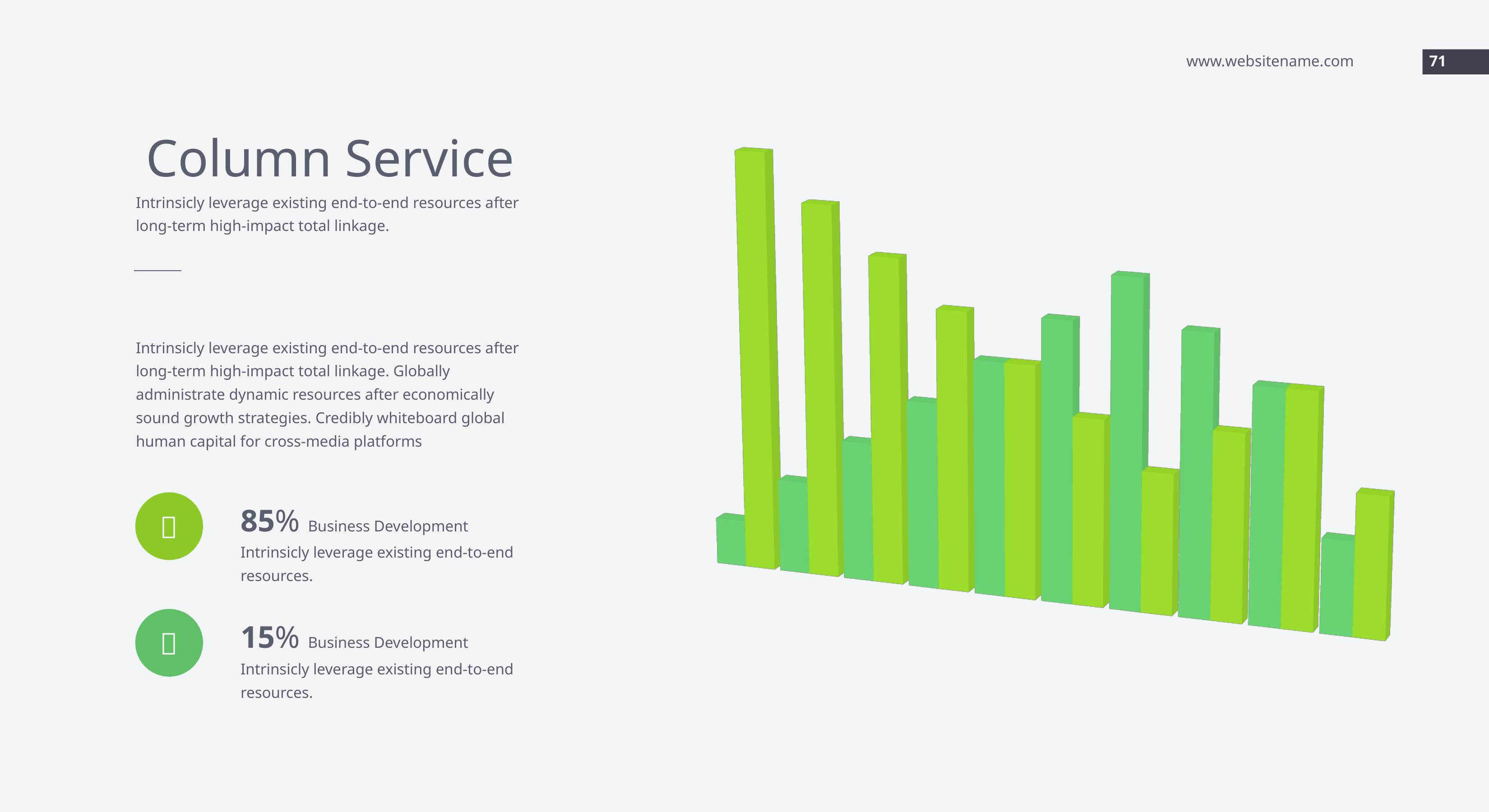
Which category has the tallest lime-green bar? the first (leftmost) category In the leftmost category, which bar is taller, the green one or the lime-green one? the lime-green one What kind of chart is shown on the slide? bar chart In the seventh category from the left, which bar is taller, the green one or the lime-green one? the green one Does the chart display any axis labels or data labels? No How many categories (pairs of bars) does the chart show? 10 How many series (bar colours) does the chart plot? 2 What is the title of the slide containing the chart? Column Service